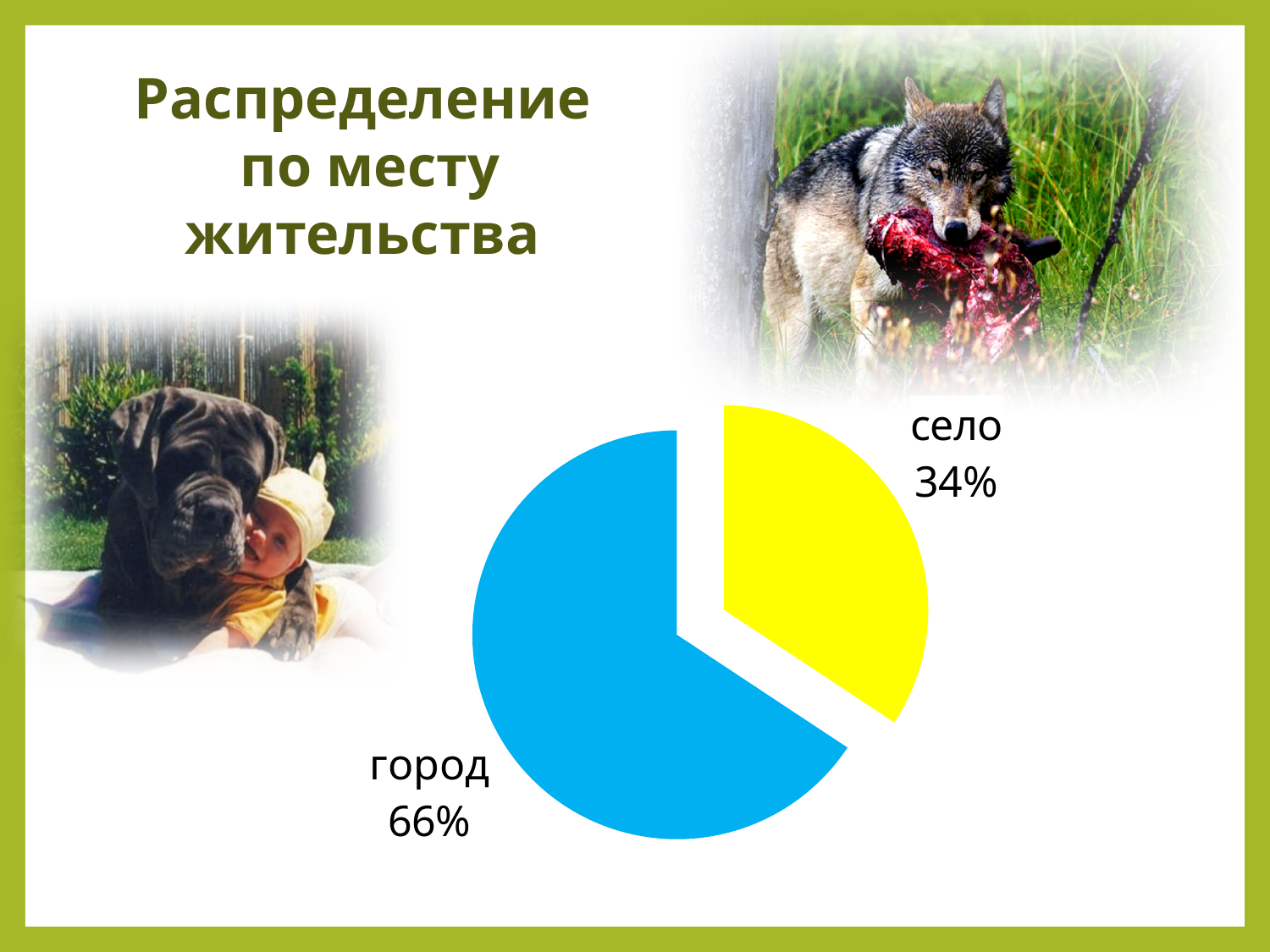
What colour is the slice for село? yellow Which category has the largest slice of the pie? город Is the share for город greater or less than 50%? greater What is the title of the slide containing the chart? Распределение по месту жительства What share of the pie does город represent? 66% What share of the pie does село represent? 34% Which is larger, the share for город or the share for село? город Which category has the smallest slice of the pie? село What is the total of the two slices shown in the pie chart? 100% How many slices does the pie chart have? 2 What is the difference in percentage points between город and село? 32 What kind of chart is shown on the slide? pie chart